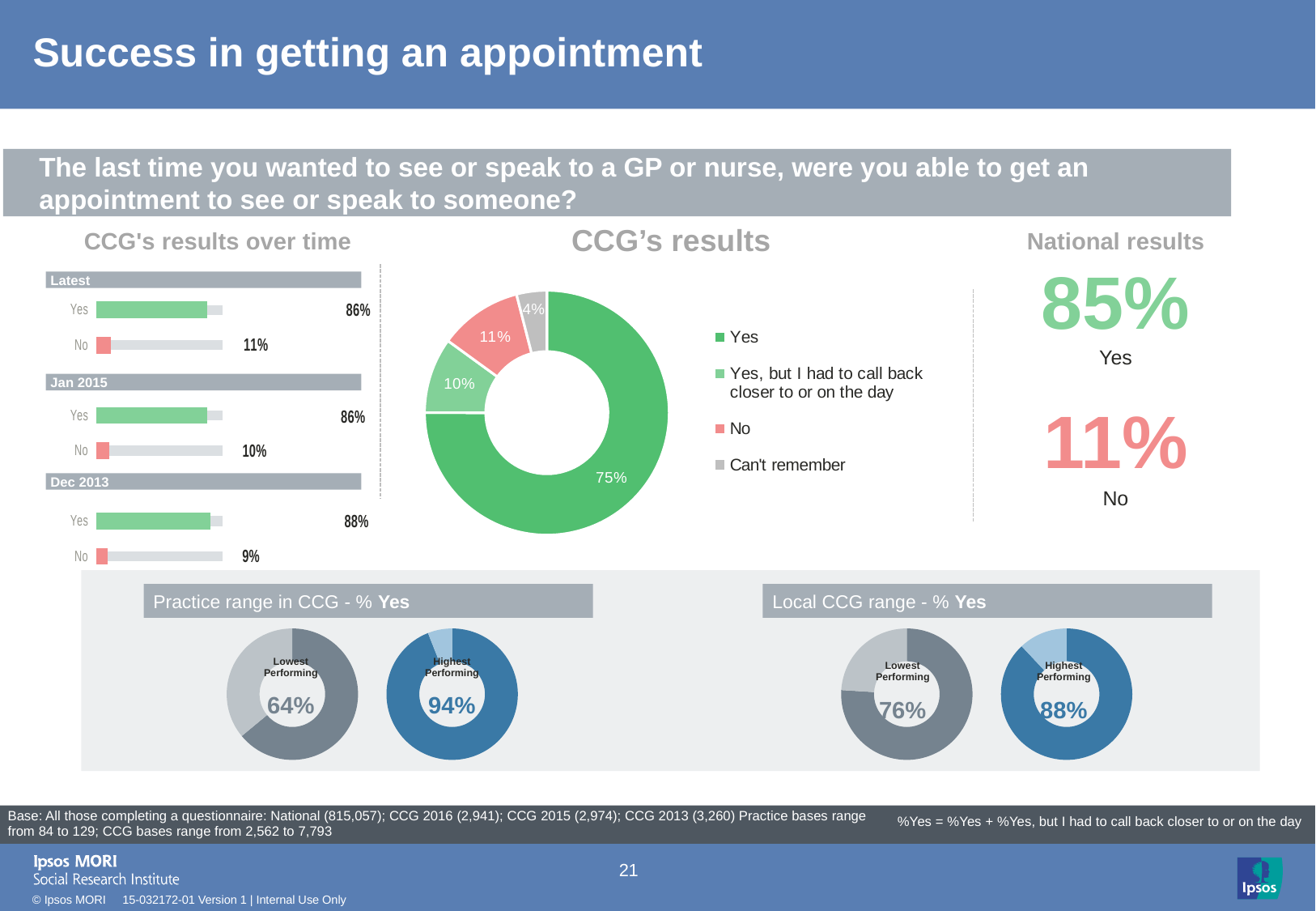
In the "CCG's results" donut chart, which category has the largest share? Yes What kind of chart is used in the "CCG's results over time" section? Bar chart In the "CCG's results over time" chart, what is the difference between the "Yes" value for Dec 2013 and the "Yes" value for the Latest period? 2% In the "CCG's results" donut chart, what percentage is shown for "No"? 11% In the "CCG's results over time" chart, what is the "No" value for the Latest period? 11% In the "Practice range in CCG - % Yes" section, what is the Highest Performing value? 94% In the "CCG's results over time" chart, what is the "Yes" value for Dec 2013? 88% In the "CCG's results" donut chart, what percentage is shown for "Can't remember"? 4% How many categories does the legend of the "CCG's results" donut chart list? 4 In the "CCG's results" donut chart, which category has the smallest share? Can't remember In the "CCG's results" donut chart, what percentage is shown for "Yes"? 75% In the "Local CCG range - % Yes" section, what is the difference between the Highest Performing and Lowest Performing values? 12%